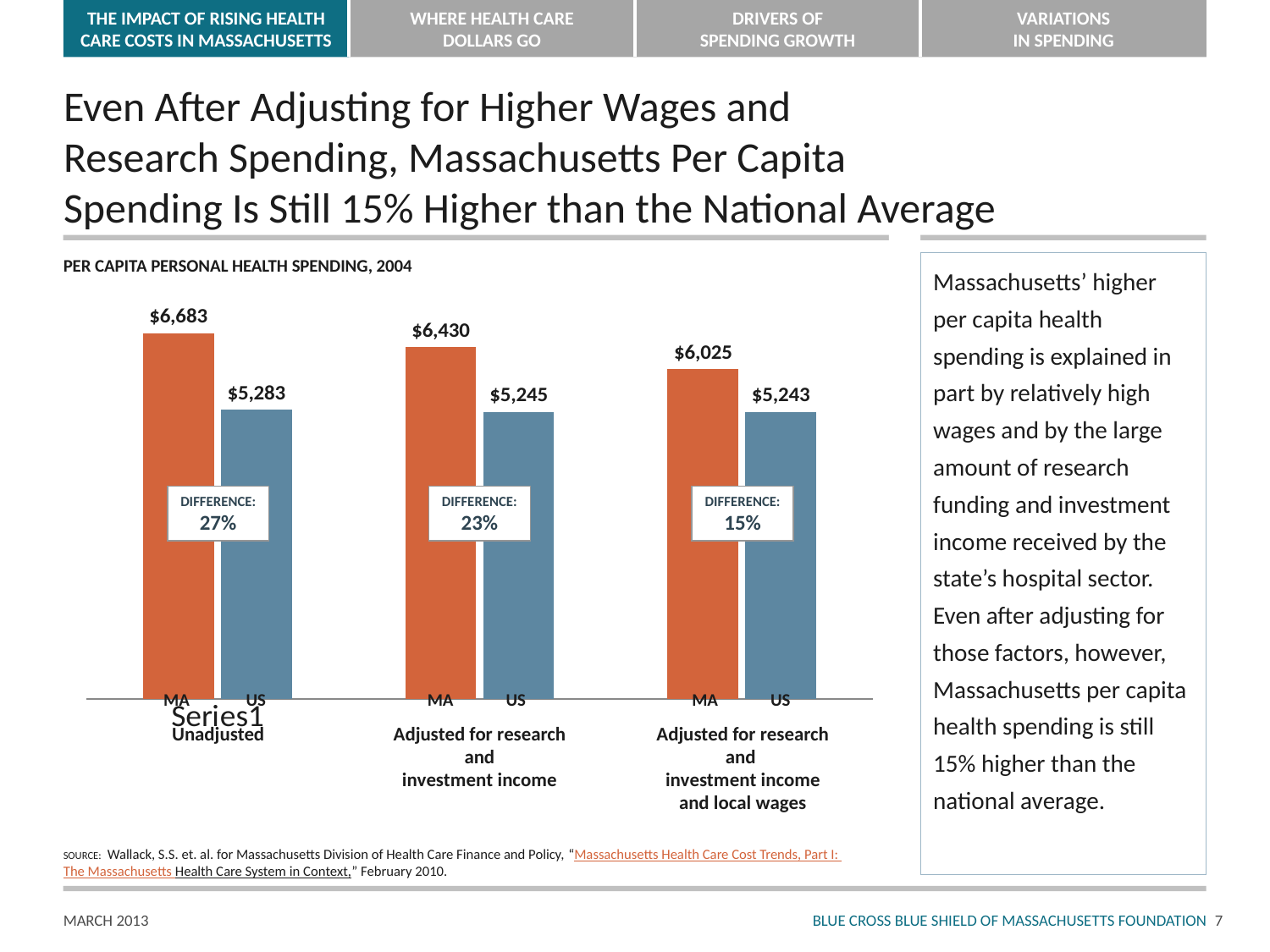
What is the US value in the group adjusted for research and investment income and local wages? $5,243 Which is larger in the group adjusted for research and investment income and local wages, the MA value or the US value? MA Which bar on the chart has the highest value? MA, Unadjusted What percentage difference is shown for the group adjusted for research and investment income? 23% Which bar on the chart has the lowest value? US, Adjusted for research and investment income and local wages What is the MA value in the group adjusted for research and investment income? $6,430 How many groups of bars are shown on the chart? 3 Do the MA values rise or fall moving from the Unadjusted group to the group adjusted for research, investment income and local wages? Fall What kind of chart is shown on the slide? Bar chart What is the difference between the MA and US values in the Unadjusted group? $1,400 What is the per capita personal health spending for MA in the Unadjusted group? $6,683 What is the per capita personal health spending for US in the Unadjusted group? $5,283